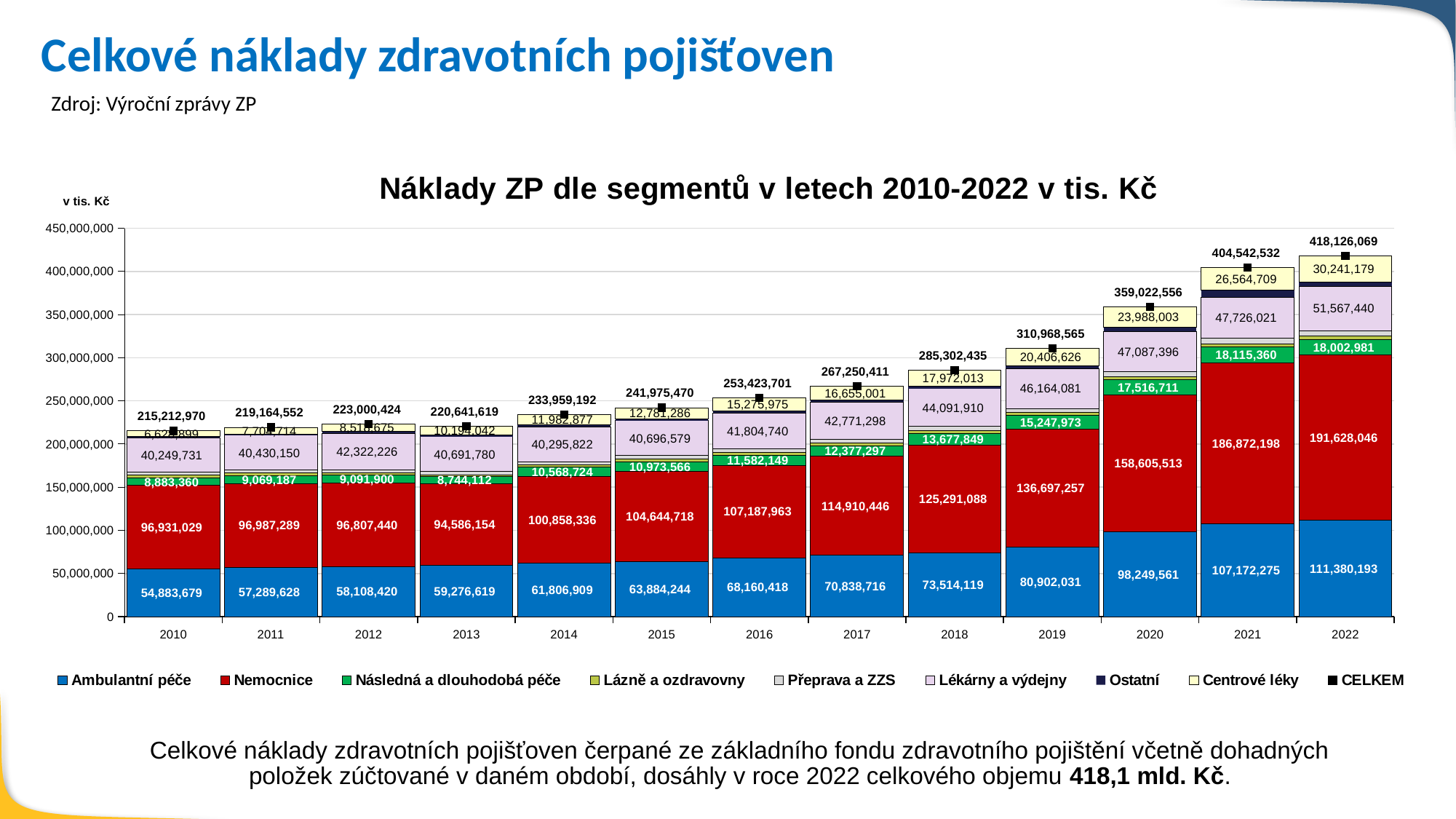
How many years are shown on the x axis? 13 Which year has the lowest total (CELKEM) value? 2010 What is the value for Ambulantní péče in 2010? 54,883,679 How many entries does the legend list? 9 Is the total for 2019 greater or less than 300,000,000? greater What type of chart is shown on the slide? Stacked bar chart What is the total (CELKEM) value for 2022? 418,126,069 What is the difference between the total for 2022 and the total for 2010? 202,913,099 Which is larger, the Nemocnice value in 2021 or in 2022? 2022 What is the value for Nemocnice in 2022? 191,628,046 Which year has the highest total (CELKEM) value? 2022 What is the value for Lékárny a výdejny in 2020? 47,087,396